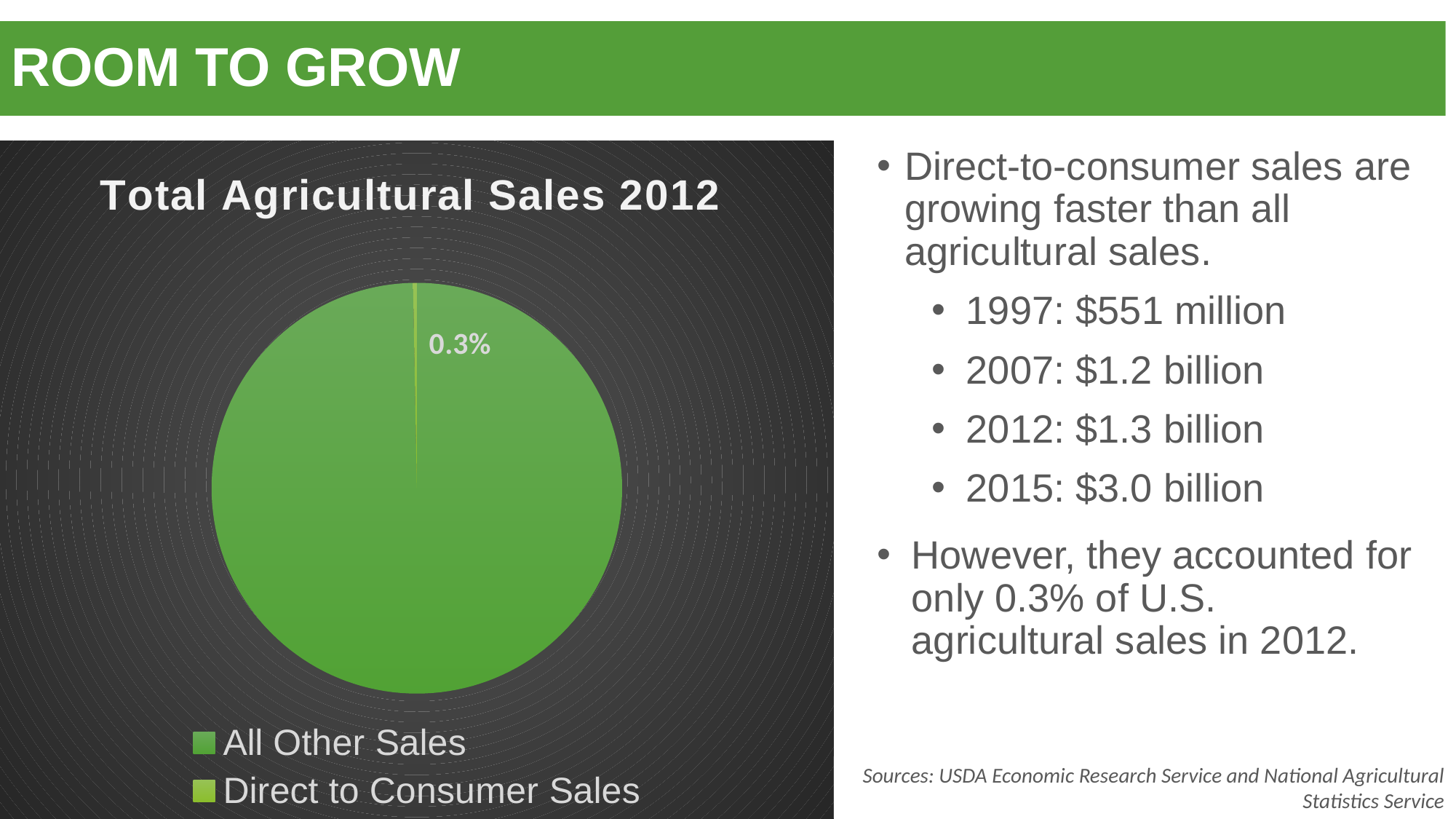
What kind of chart is shown on the slide? pie chart How many slices does the pie chart have? 2 What share of the pie does Direct to Consumer Sales account for? 0.3% Which is larger, All Other Sales or Direct to Consumer Sales? All Other Sales What value is printed as the data label on the pie chart? 0.3% Which slice of the pie chart is the smallest? Direct to Consumer Sales What is the title of the chart? Total Agricultural Sales 2012 What are the two categories listed in the chart legend? All Other Sales and Direct to Consumer Sales How many entries does the chart legend list? 2 Which slice of the pie chart is the largest? All Other Sales